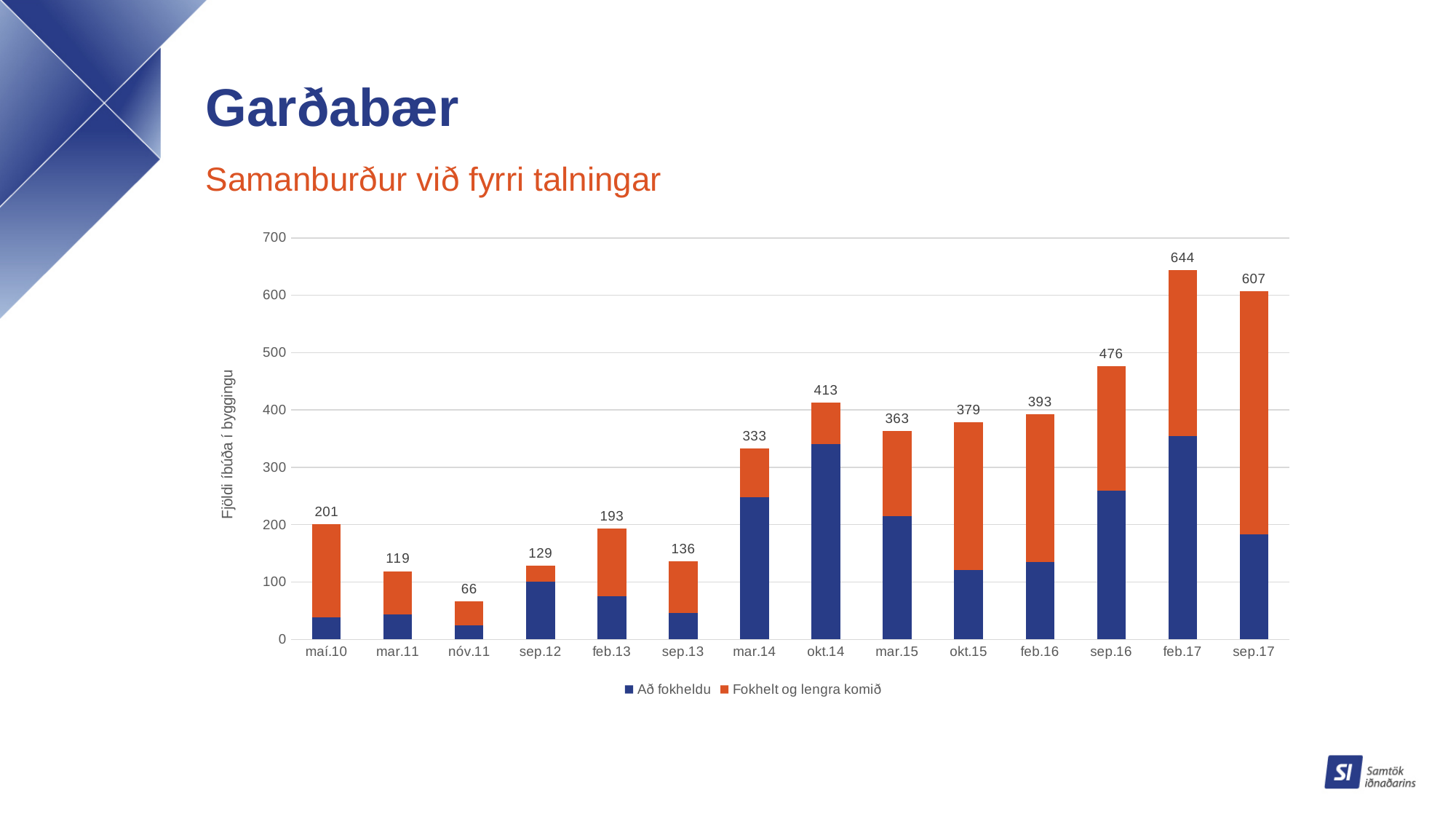
What kind of chart is shown on the slide? Stacked bar chart What is the total value labelled above the bar for nóv.11? 66 Which total is larger, okt.15 or feb.16? feb.16 Is the 'Að fokheldu' value for sep.17 greater or less than 200? less How many periods are shown on the x axis? 14 Which period has the highest total bar? feb.17 What is the total number of íbúðir í byggingu shown for feb.17? 644 What is the difference between the total for sep.17 and the total for feb.17? 37 What is the difference between the total for okt.14 and the total for mar.14? 80 Is the 'Að fokheldu' value for okt.14 greater or less than 300? greater Which period has the lowest total bar? nóv.11 How many series does the legend list? 2